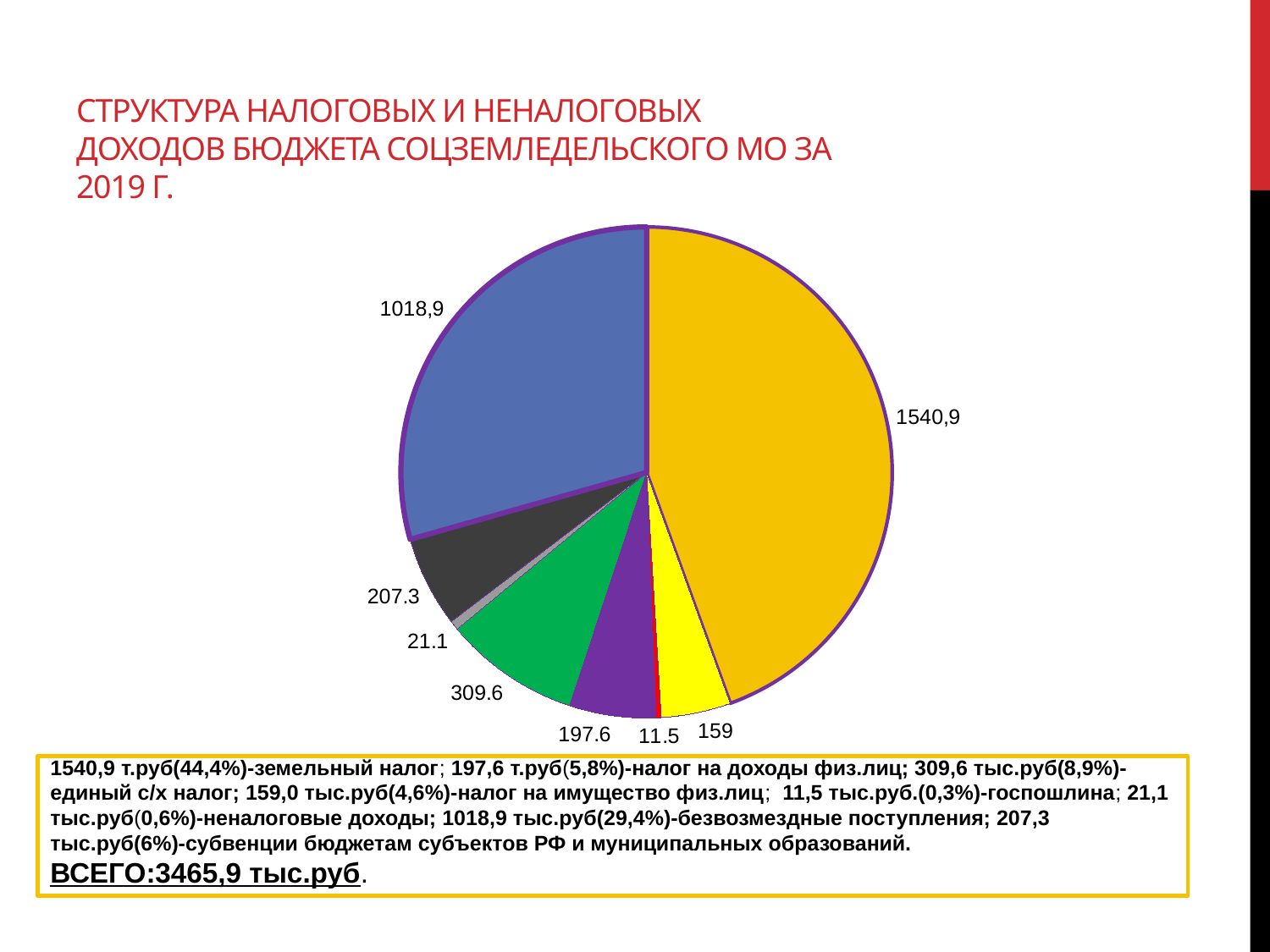
Which value is the smallest slice of the pie chart? 11.5 What is the value of the blue slice of the pie chart? 1018,9 Which is larger: the slice labelled 309.6 or the slice labelled 207.3? 309.6 What is the value of the green slice of the pie chart? 309.6 What is the difference between the largest slice (1540,9) and the second largest slice (1018,9)? 522 According to the text box, what share of the total does земельный налог (1540,9) represent? 44,4% What is the total (ВСЕГО) of all revenues shown on the slide? 3465,9 тыс.руб According to the text box, what share of the total do безвозмездные поступления (1018,9) represent? 29,4% How many slices does the pie chart have? 8 What is the value of the yellow (light) slice of the pie chart? 159 What kind of chart is shown on the slide? pie chart Which value is the largest slice of the pie chart? 1540,9